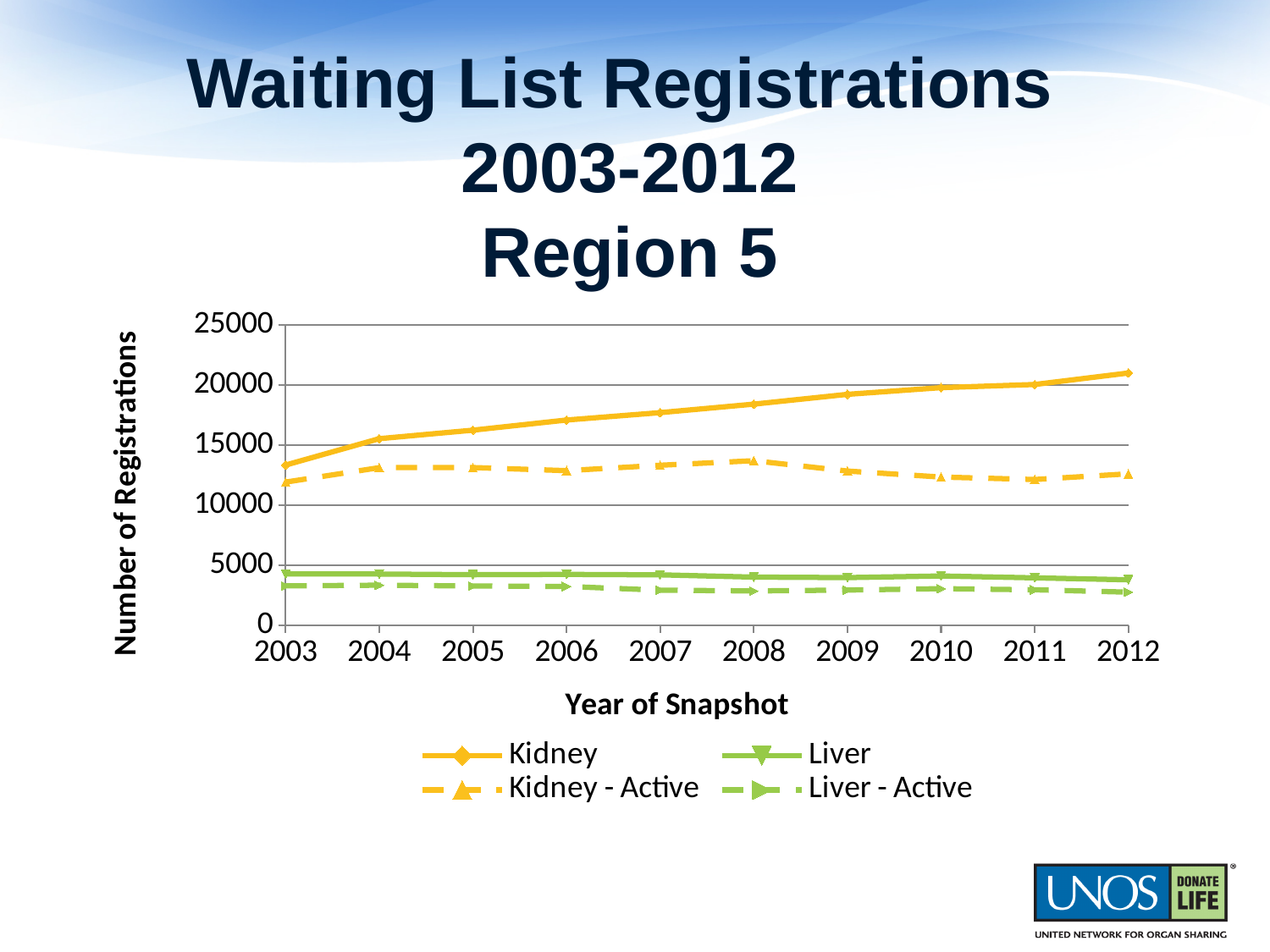
Is the value for Kidney - Active in 2008 greater or less than 10000? greater What is the title of the y axis? Number of Registrations In which year is the Kidney series at its lowest? 2003 Is the value for Kidney in 2012 greater or less than 20000? greater Does the Kidney series rise or fall from 2003 to 2012? rise In which year is the Kidney series at its highest? 2012 What kind of chart is shown on the slide? line chart Is the value for Kidney in 2003 greater or less than 15000? less In 2012, which is larger: Kidney or Kidney - Active? Kidney How many years are plotted along the x axis? 10 How many series does the legend list? 4